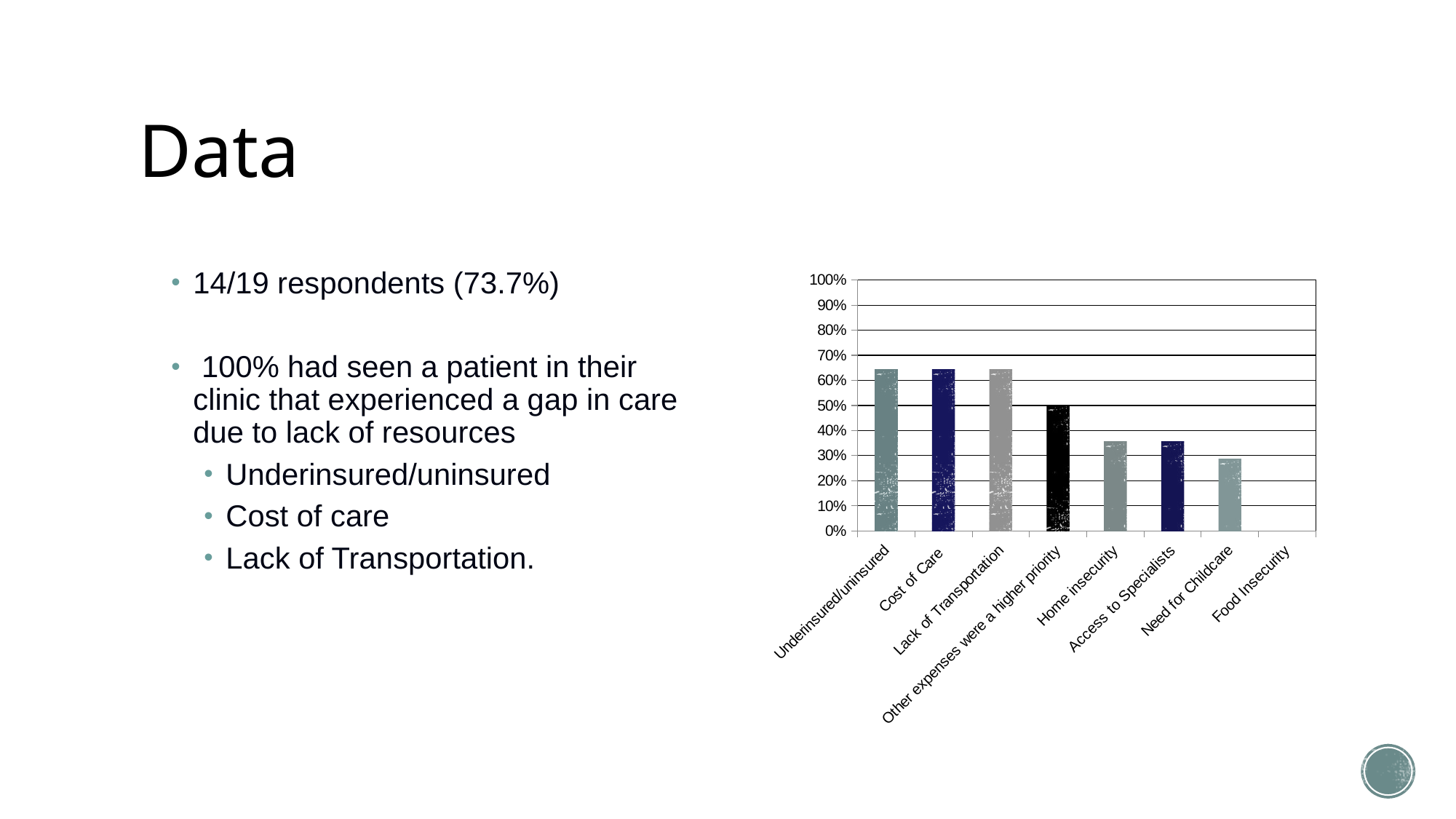
Is the value for Other expenses were a higher priority greater or less than 40%? greater Is the value for Home insecurity greater or less than 40%? less Which category has the lowest value in the chart? Food Insecurity Is the value for Lack of Transportation greater or less than 70%? less What is the highest value shown on the y axis of the chart? 100% Which is larger, the value for Cost of Care or the value for Home insecurity? Cost of Care Which is larger, the value for Access to Specialists or the value for Need for Childcare? Access to Specialists What kind of chart is shown on the slide? bar chart Which is larger, the value for Other expenses were a higher priority or the value for Underinsured/uninsured? Underinsured/uninsured How many categories are shown on the x axis of the chart? 8